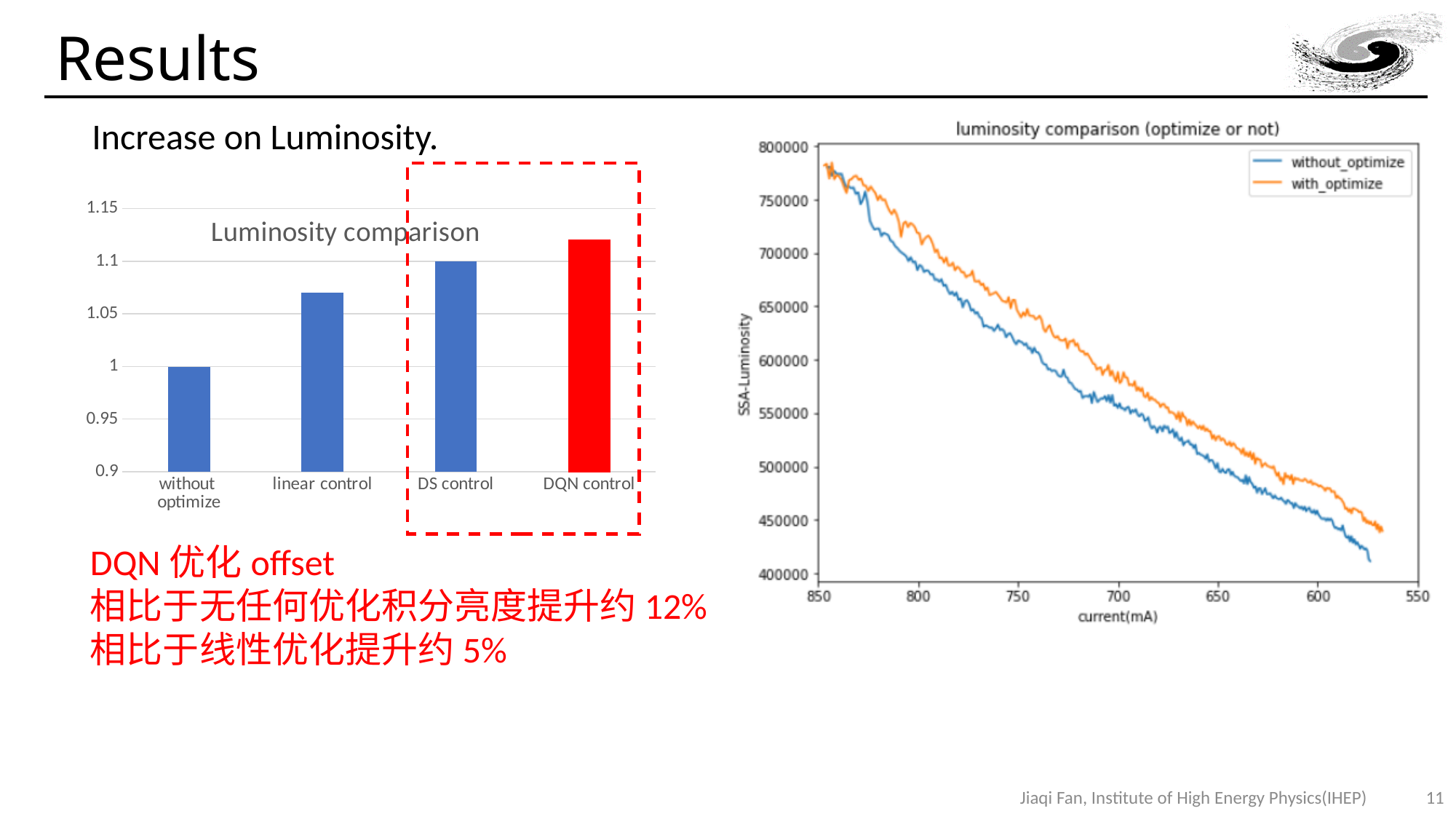
In the 'Luminosity comparison' bar chart, what is the value for 'DS control'? 1.1 In the 'Luminosity comparison' bar chart, is the value for 'DQN control' greater or less than 1.15? less In the 'luminosity comparison (optimize or not)' chart, do the SSA-Luminosity values rise or fall moving from left to right along the x axis? fall What kind of chart is the 'Luminosity comparison' chart on the left? bar chart In the 'Luminosity comparison' bar chart, which category has the highest value? DQN control How many series does the legend of the 'luminosity comparison (optimize or not)' chart list? 2 In the 'Luminosity comparison' bar chart, which bar is coloured red? DQN control In the 'Luminosity comparison' bar chart, which category has the lowest value? without optimize How many categories are shown in the 'Luminosity comparison' bar chart? 4 In the 'Luminosity comparison' bar chart, what is the value for 'without optimize'? 1 In the 'Luminosity comparison' bar chart, is the value for 'linear control' greater or less than 1.05? greater In the 'Luminosity comparison' bar chart, which is larger: the value for 'linear control' or the value for 'DS control'? DS control